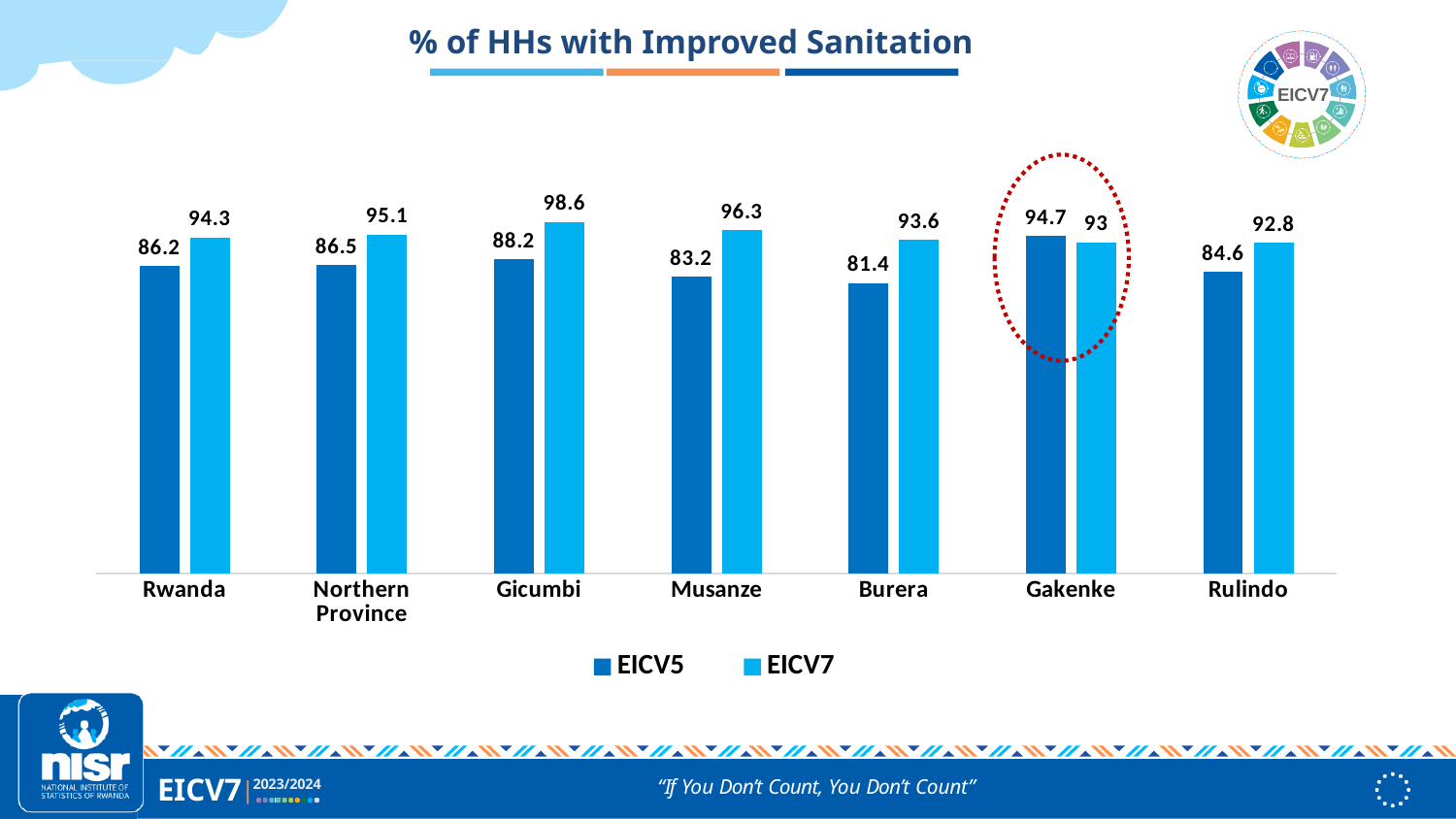
What is the title of the chart? % of HHs with Improved Sanitation For Gakenke, which is larger: the EICV5 value or the EICV7 value? EICV5 Which category has the lowest EICV5 value? Burera What is the EICV7 value for Gicumbi? 98.6 What is the EICV7 value for Gakenke? 93 Which category has the highest EICV7 value? Gicumbi What kind of chart is shown on the slide? Bar chart How many series does the legend list? 2 What is the difference between the EICV7 and EICV5 values for Musanze? 13.1 What is the EICV5 value for Burera? 81.4 How many categories are shown on the x axis? 7 Which category is highlighted with a red dotted circle? Gakenke